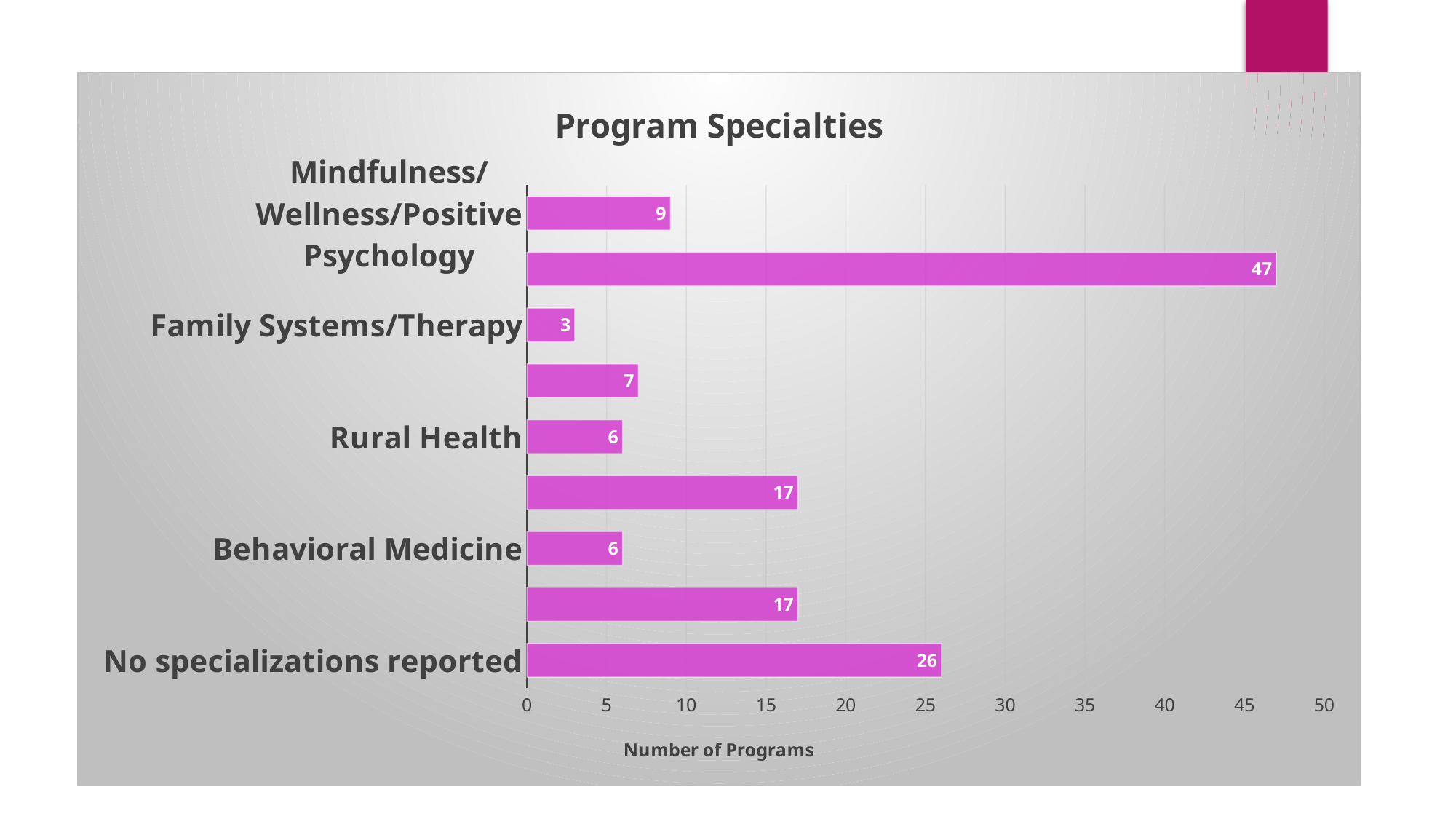
What is the label on the horizontal axis of the chart? Number of Programs What is the largest value shown by any bar in the chart? 47 What is the difference in number of programs between No specializations reported and Mindfulness/Wellness/Positive Psychology? 17 What is the number of programs for Behavioral Medicine? 6 What type of chart is shown on the slide? bar chart What is the number of programs for No specializations reported? 26 Which labeled category has the lowest number of programs? Family Systems/Therapy How many bars are plotted in the chart? 9 What is the title of the chart? Program Specialties What is the number of programs for Rural Health? 6 What is the number of programs for Family Systems/Therapy? 3 What is the number of programs for Mindfulness/Wellness/Positive Psychology? 9